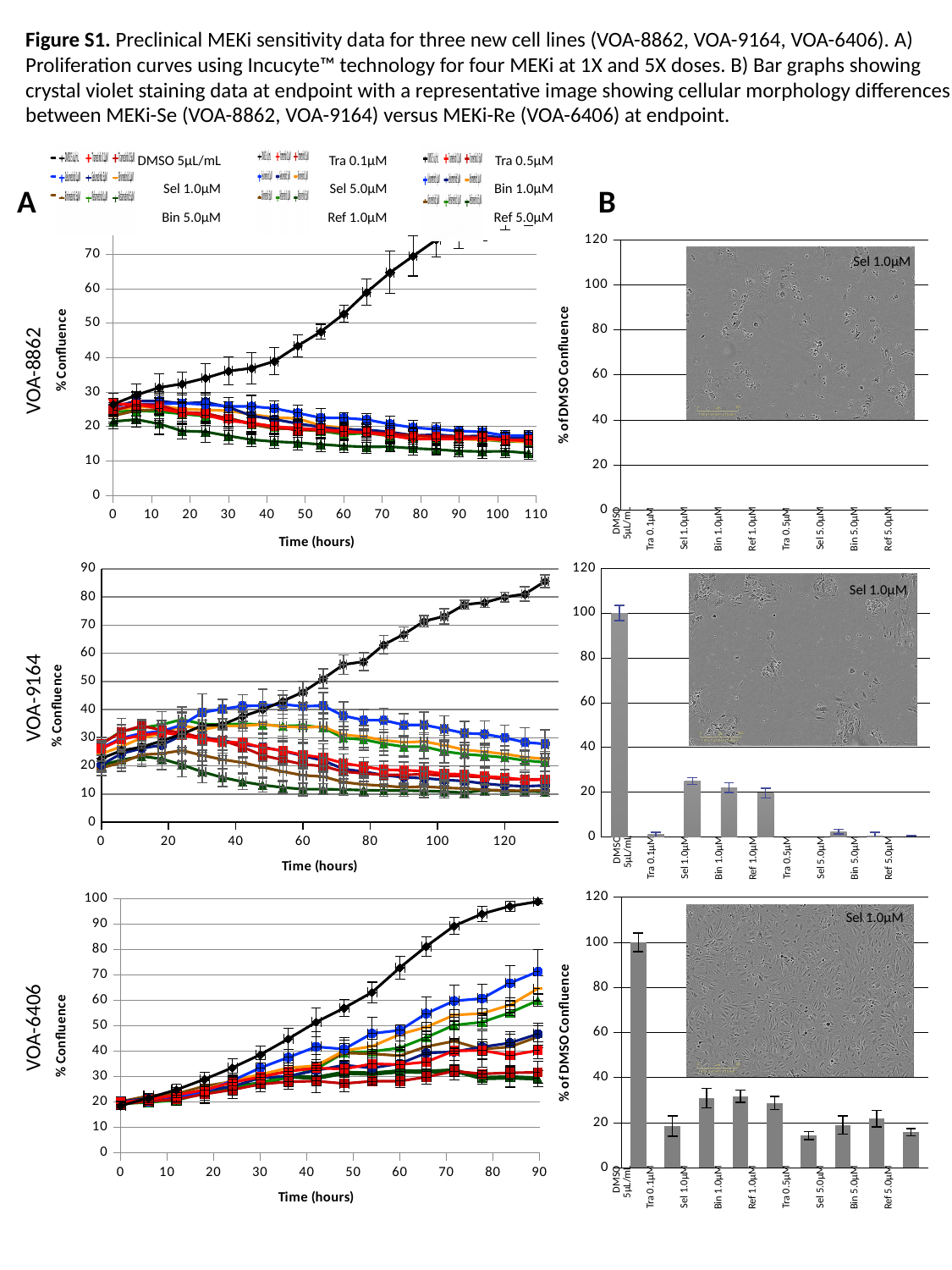
What is the y-axis label of the bar charts in panel B? % of DMSO Confluence What kind of chart is the VOA-9164 chart in panel B? bar chart In the VOA-9164 bar chart in panel B, is the value for Sel 1.0µM greater or less than 20? greater How many series does the shared legend above panel A list? 9 In the VOA-6406 proliferation chart in panel A, does the DMSO 5µL/mL line rise or fall over time? rise In the VOA-6406 bar chart in panel B, is the value for Bin 1.0µM greater or less than 20? greater What kind of chart is the VOA-6406 proliferation chart in panel A? line chart In the VOA-9164 bar chart in panel B, which category has the highest value? DMSO 5µL/mL In the VOA-6406 bar chart in panel B, which category has the highest value? DMSO 5µL/mL In the VOA-6406 bar chart in panel B, is the value for Tra 0.5µM greater or less than 20? less How many categories are shown on the x axis of the VOA-6406 bar chart in panel B? 9 In the VOA-6406 bar chart in panel B, which is larger, the value for DMSO 5µL/mL or the value for Sel 1.0µM? DMSO 5µL/mL